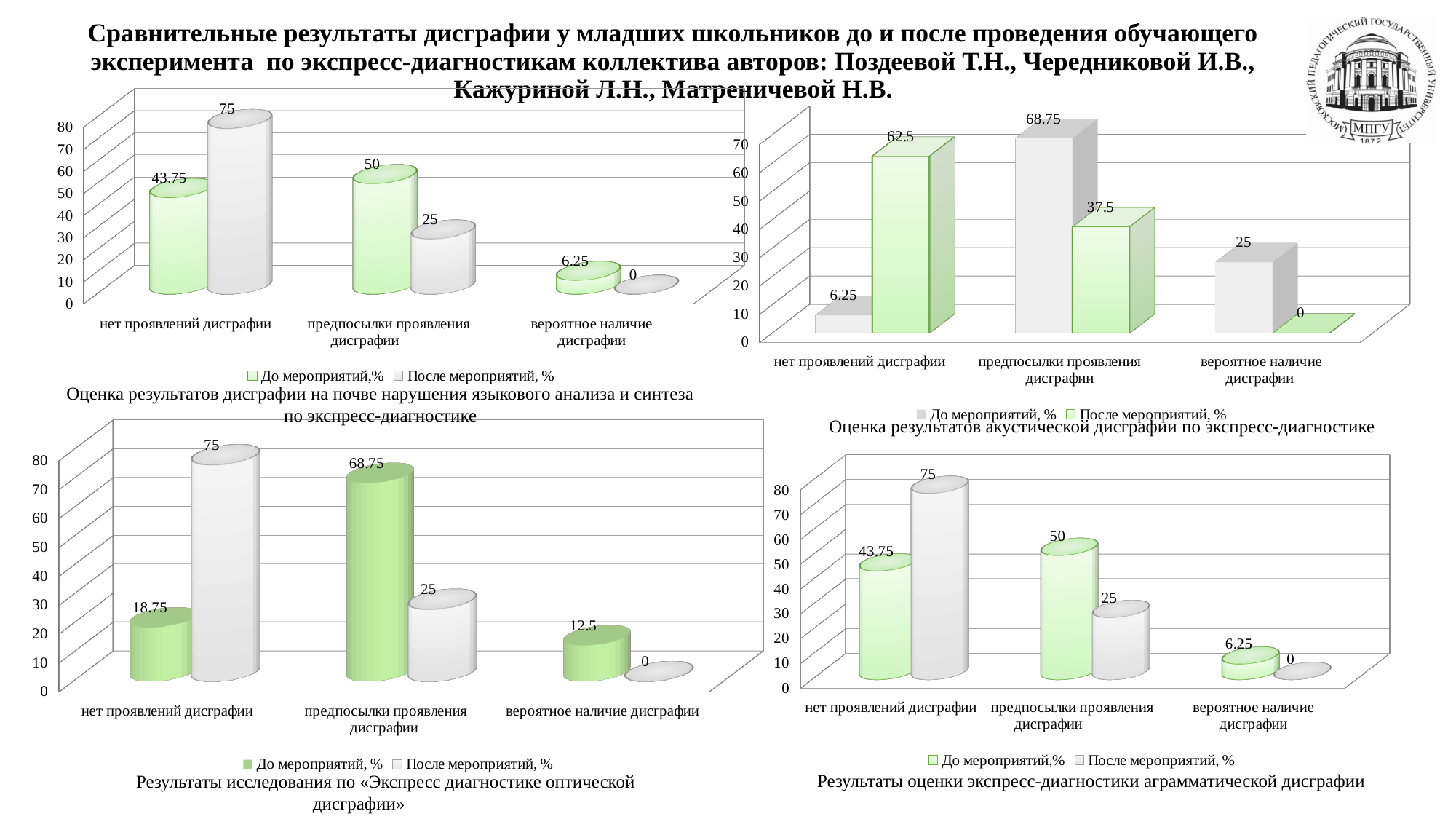
In the top-right chart (акустической дисграфии), which category has the highest value in the 'До мероприятий, %' series? предпосылки проявления дисграфии In the top-left chart (языкового анализа и синтеза), what is the value for 'предпосылки проявления дисграфии' in the 'После мероприятий, %' series? 25 In the bottom-left chart (оптической дисграфии), what is the value for 'нет проявлений дисграфии' in the 'До мероприятий, %' series? 18.75 In the bottom-left chart (оптической дисграфии), which category has the lowest value in the 'После мероприятий, %' series? вероятное наличие дисграфии In the top-right chart (акустической дисграфии), what is the difference between the 'До мероприятий, %' and 'После мероприятий, %' values for 'предпосылки проявления дисграфии'? 31.25 How many charts are shown on the slide? 4 In the bottom-right chart (аграмматической дисграфии), what is the difference between the 'После мероприятий, %' and 'До мероприятий,%' values for 'нет проявлений дисграфии'? 31.25 In the top-left chart (языкового анализа и синтеза), what is the value for 'нет проявлений дисграфии' in the 'До мероприятий,%' series? 43.75 How many series does the legend of the top-right chart (акустической дисграфии) list? 2 In the top-right chart (акустической дисграфии), what is the value for 'нет проявлений дисграфии' in the 'После мероприятий, %' series? 62.5 In the bottom-left chart (оптической дисграфии), which is larger for 'предпосылки проявления дисграфии': the 'До мероприятий, %' value or the 'После мероприятий, %' value? До мероприятий, % In the bottom-right chart (аграмматической дисграфии), what is the value for 'вероятное наличие дисграфии' in the 'До мероприятий,%' series? 6.25